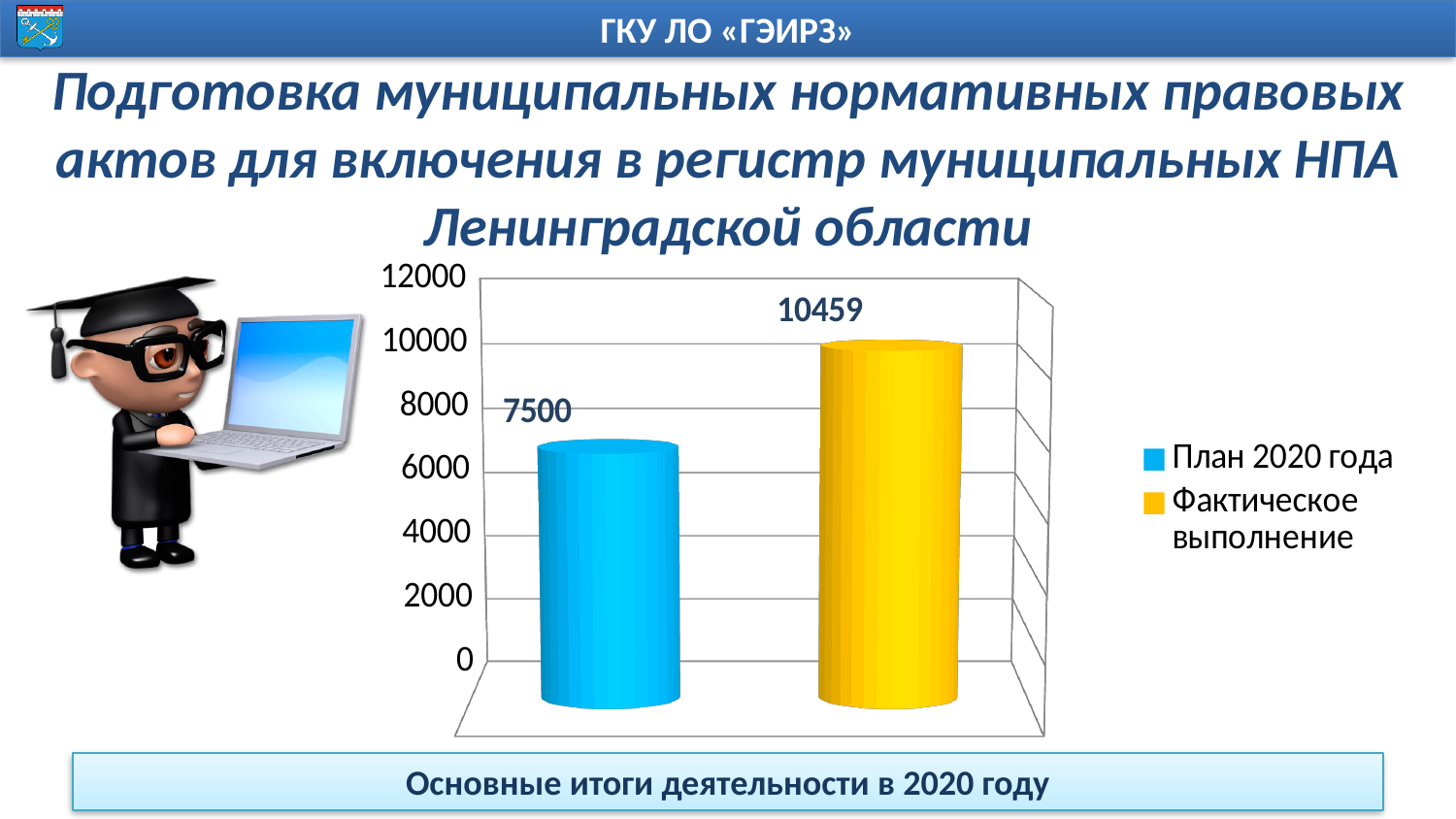
What is the difference between Фактическое выполнение and План 2020 года? 2959 Is the value for Фактическое выполнение greater or less than 10000? greater What is the value for План 2020 года? 7500 Which bar shows the lowest value? План 2020 года What kind of chart is shown on the slide? Bar chart How many bars are plotted on the chart? 2 Is the value for План 2020 года greater or less than 8000? less Which series has the higher value, План 2020 года or Фактическое выполнение? Фактическое выполнение How many series does the legend list? 2 Which bar shows the highest value? Фактическое выполнение What is the value for Фактическое выполнение? 10459 What colour is the bar for Фактическое выполнение? Yellow